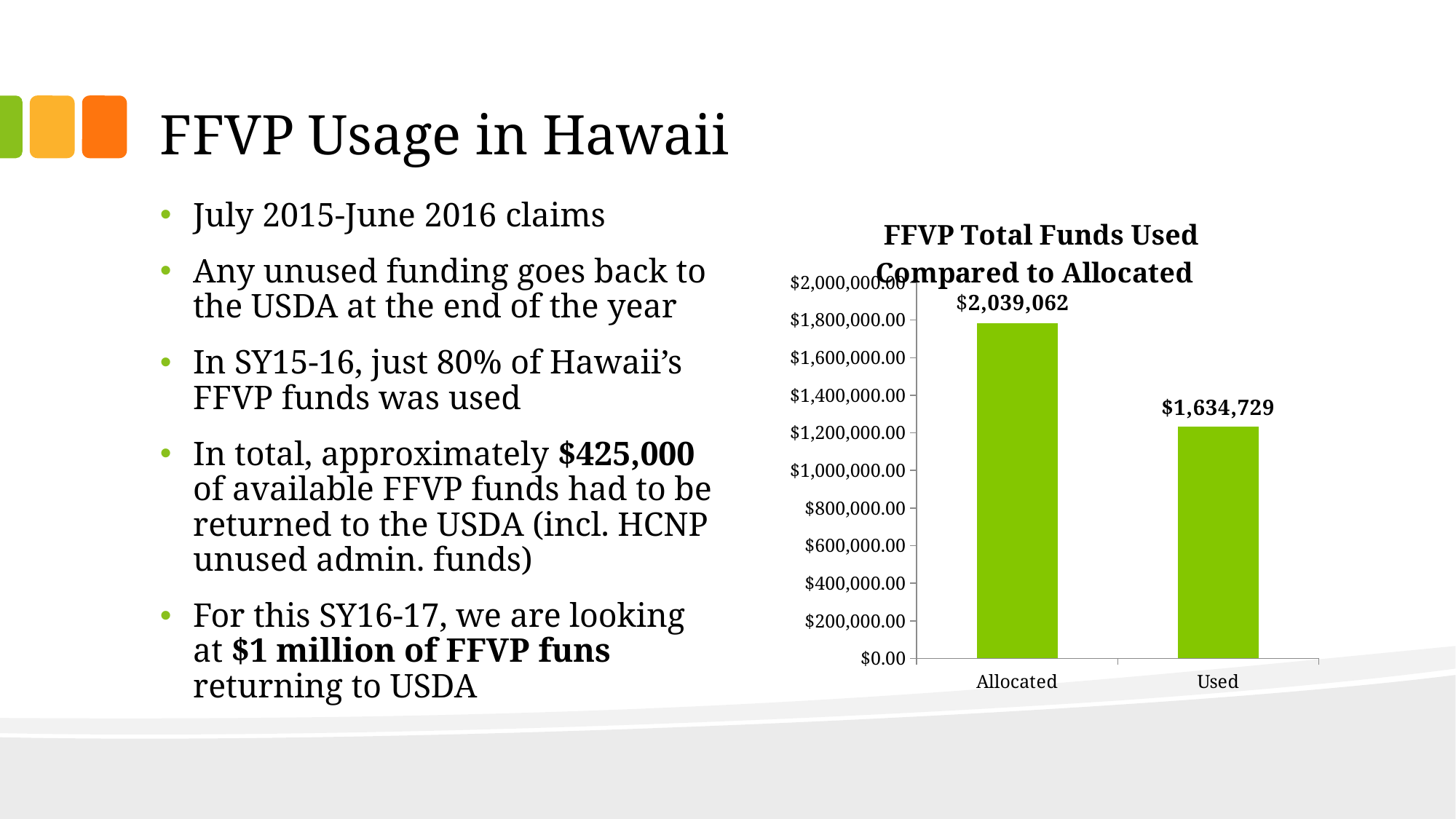
What is the difference between the Allocated and Used values in the chart? $404,333 Which category has the lowest value in the chart? Used What is the value for Allocated in the FFVP Total Funds Used Compared to Allocated chart? $2,039,062 Is the value for Used greater or less than $1,800,000.00? less What is the title of the chart on the slide? FFVP Total Funds Used Compared to Allocated What colour are the bars in the chart? Green What is the value for Used in the FFVP Total Funds Used Compared to Allocated chart? $1,634,729 Which category has the highest value in the chart? Allocated Is the value for Used greater or less than $1,000,000.00? greater Which is larger in the chart, the value for Allocated or the value for Used? Allocated How many categories are shown in the chart? 2 What kind of chart is shown on the slide? Bar chart